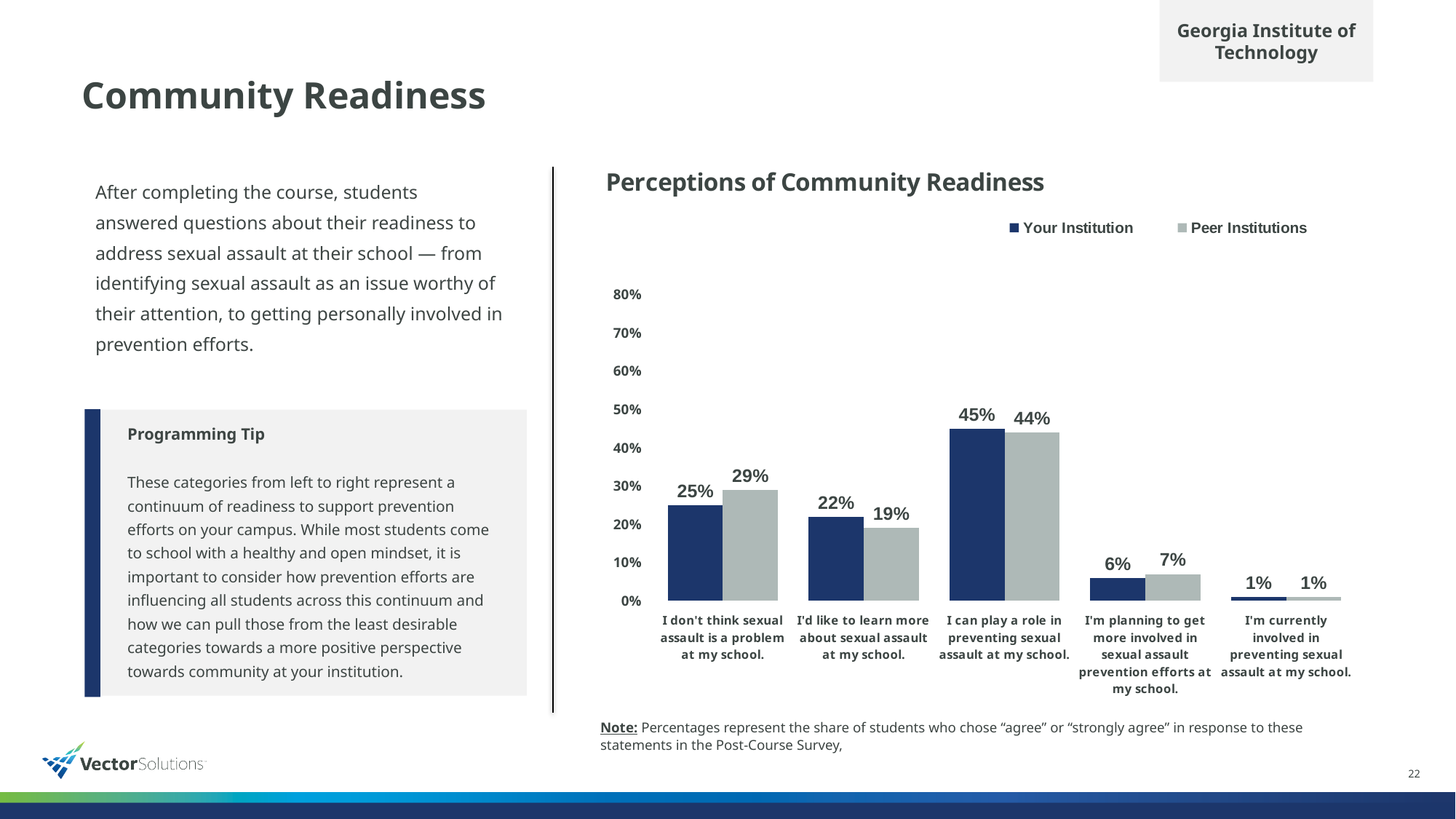
Which category has the highest Your Institution value? I can play a role in preventing sexual assault at my school. What kind of chart is shown on the slide? Bar chart What is the difference between the Peer Institutions and Your Institution values for "I don't think sexual assault is a problem at my school."? 4% Which category has the lowest Peer Institutions value? I'm currently involved in preventing sexual assault at my school. What is the Your Institution value for "I'd like to learn more about sexual assault at my school."? 22% What is the Your Institution value for "I can play a role in preventing sexual assault at my school."? 45% How many series does the legend list? 2 For "I'd like to learn more about sexual assault at my school.", which series has the larger value, Your Institution or Peer Institutions? Your Institution How many categories are shown on the x axis of the chart? 5 What is the Peer Institutions value for "I don't think sexual assault is a problem at my school."? 29% What is the title of the chart? Perceptions of Community Readiness Is the Your Institution value for "I can play a role in preventing sexual assault at my school." greater or less than 40%? greater